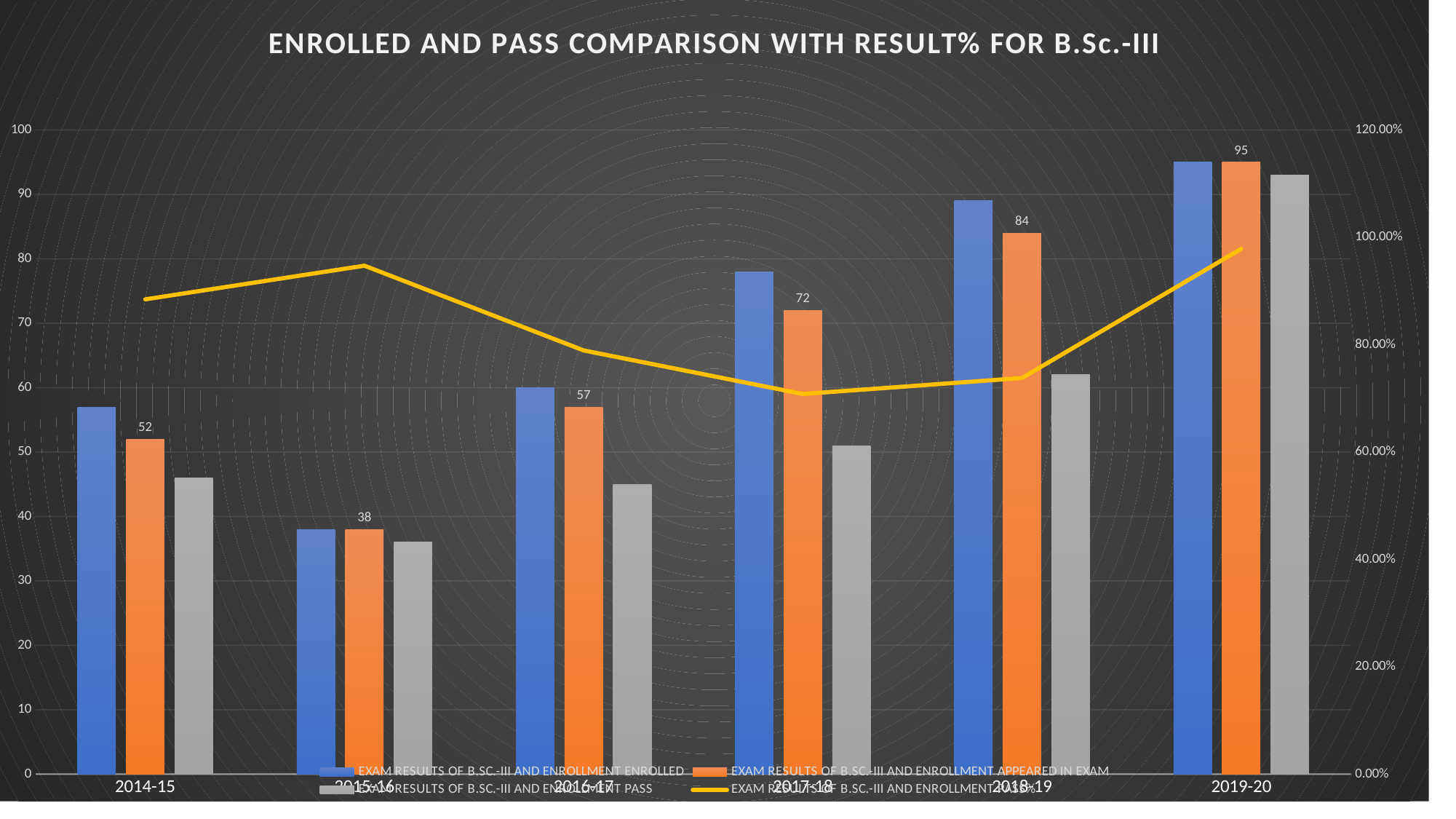
What is the value for APPEARED IN EXAM in 2017-18? 72 What is the difference between the APPEARED IN EXAM values for 2019-20 and 2014-15? 43 In which year is the APPEARED IN EXAM value lowest? 2015-16 How many years are shown on the x axis? 6 How many series does the legend list? 4 Is the PASS value for 2016-17 greater or less than 50? less What is the value for APPEARED IN EXAM in 2014-15? 52 Is the ENROLLED value for 2019-20 greater or less than 90? greater Which year has a larger APPEARED IN EXAM value, 2016-17 or 2015-16? 2016-17 What is the value for APPEARED IN EXAM in 2019-20? 95 What kind of chart is this? Combination bar and line chart In which year is the APPEARED IN EXAM value highest? 2019-20